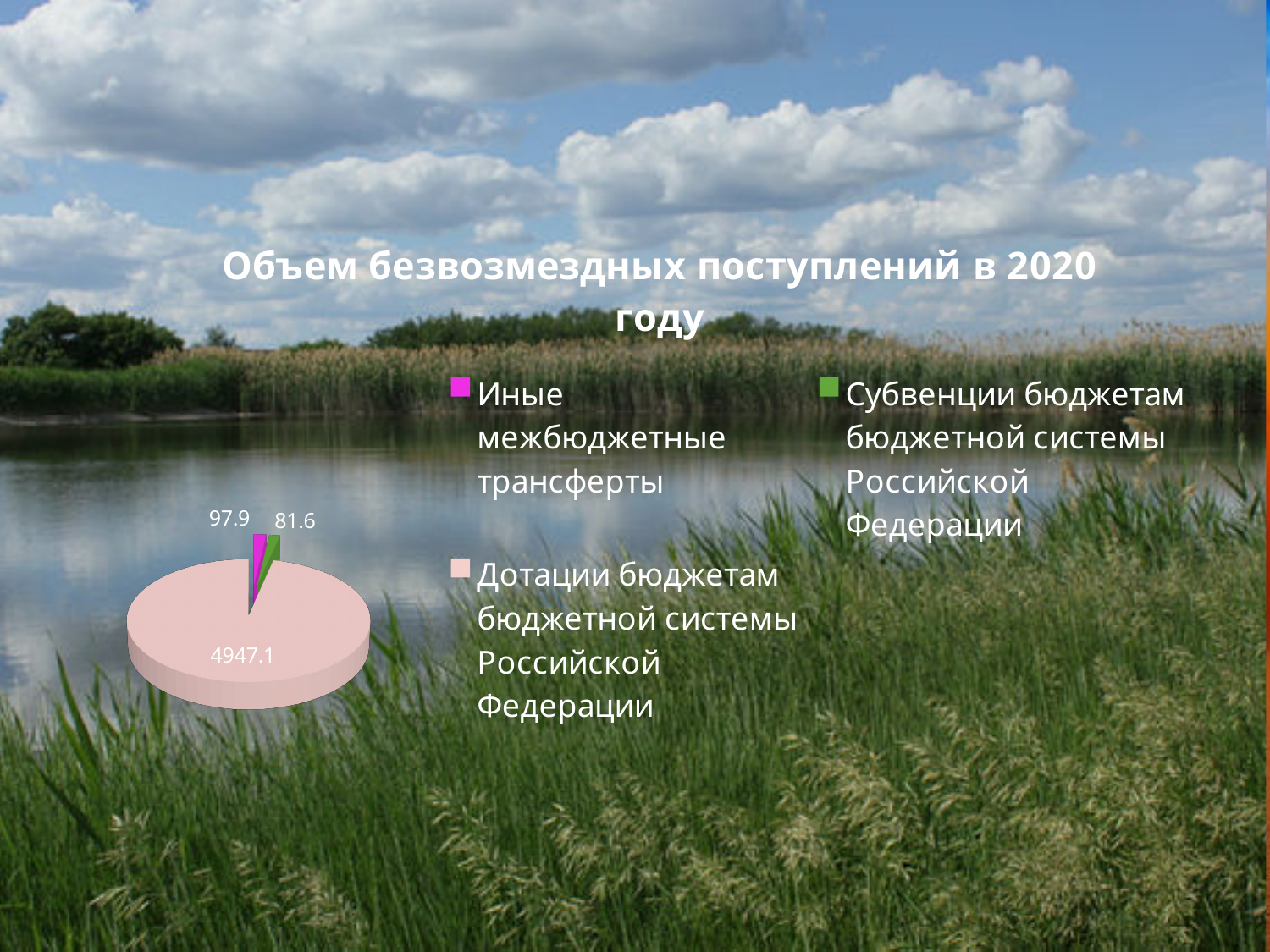
What is the value for Дотации бюджетам бюджетной системы Российской Федерации? 4947.1 How many entries does the legend list? 3 What type of chart is shown on the slide? Pie chart Which category has the smallest slice of the pie? Субвенции бюджетам бюджетной системы Российской Федерации What is the total of all three slices in the pie chart? 5126.6 Which colour represents Иные межбюджетные трансферты in the legend? Magenta What is the value for Субвенции бюджетам бюджетной системы Российской Федерации? 81.6 How many slices does the pie chart have? 3 Which category has the largest slice of the pie? Дотации бюджетам бюджетной системы Российской Федерации What is the title of the chart? Объем безвозмездных поступлений в 2020 году What is the difference between the values for Иные межбюджетные трансферты and Субвенции бюджетам бюджетной системы Российской Федерации? 16.3 What is the value for Иные межбюджетные трансферты? 97.9